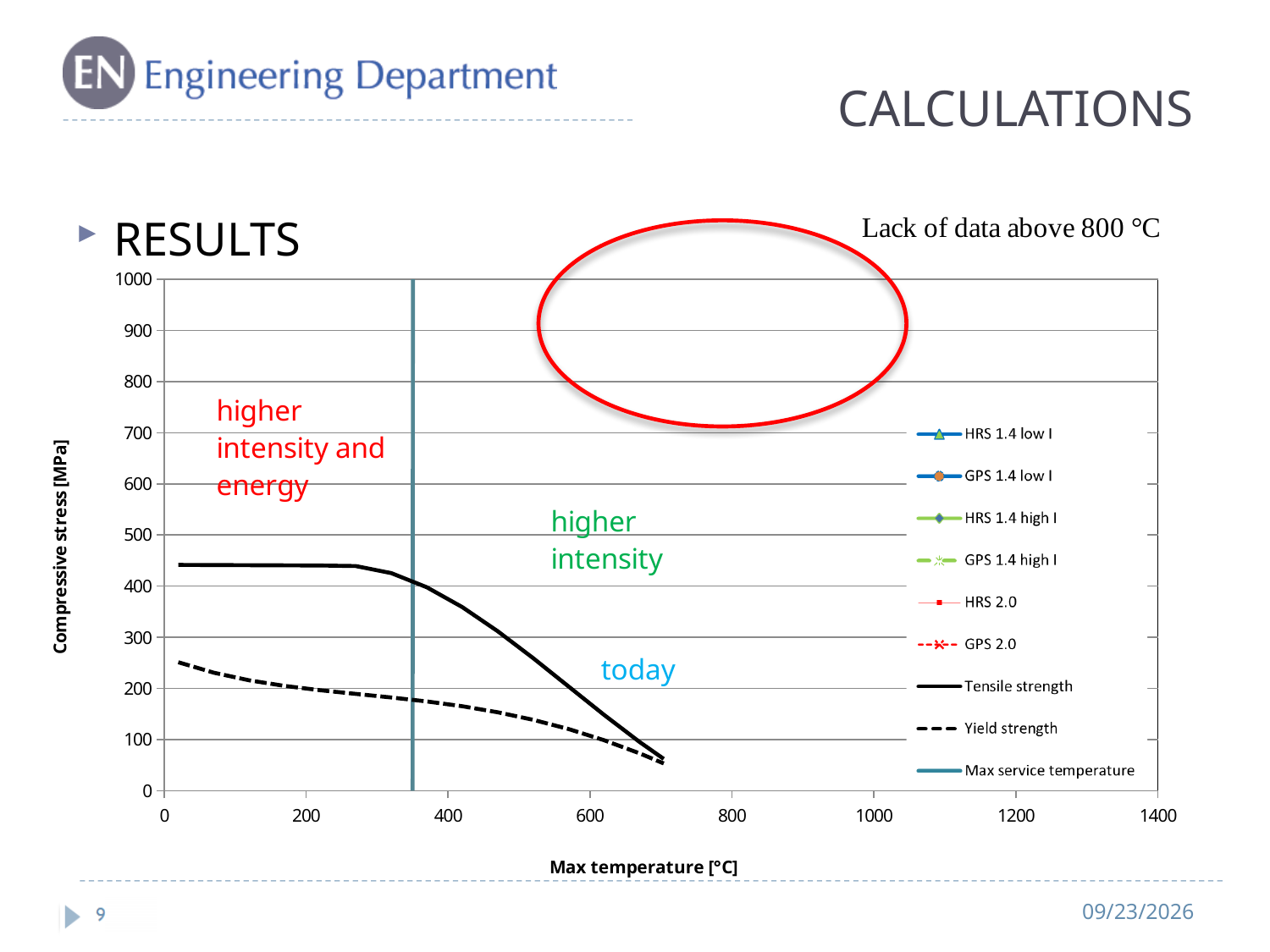
Is the Tensile strength value at 600 °C greater or less than 300 MPa? less At 400 °C, which is larger: Tensile strength or Yield strength? Tensile strength Is the Max service temperature line positioned at a temperature greater or less than 400 °C? less Is the Yield strength value at 600 °C greater or less than 200 MPa? less Does the Tensile strength line rise or fall as Max temperature increases? fall What is the label of the chart's x axis? Max temperature [°C] What does the annotation next to the red ellipse on the chart say? Lack of data above 800 °C How many series does the chart's legend list? 9 Does the Yield strength line rise or fall as Max temperature increases? fall What kind of chart is shown on the slide? line chart